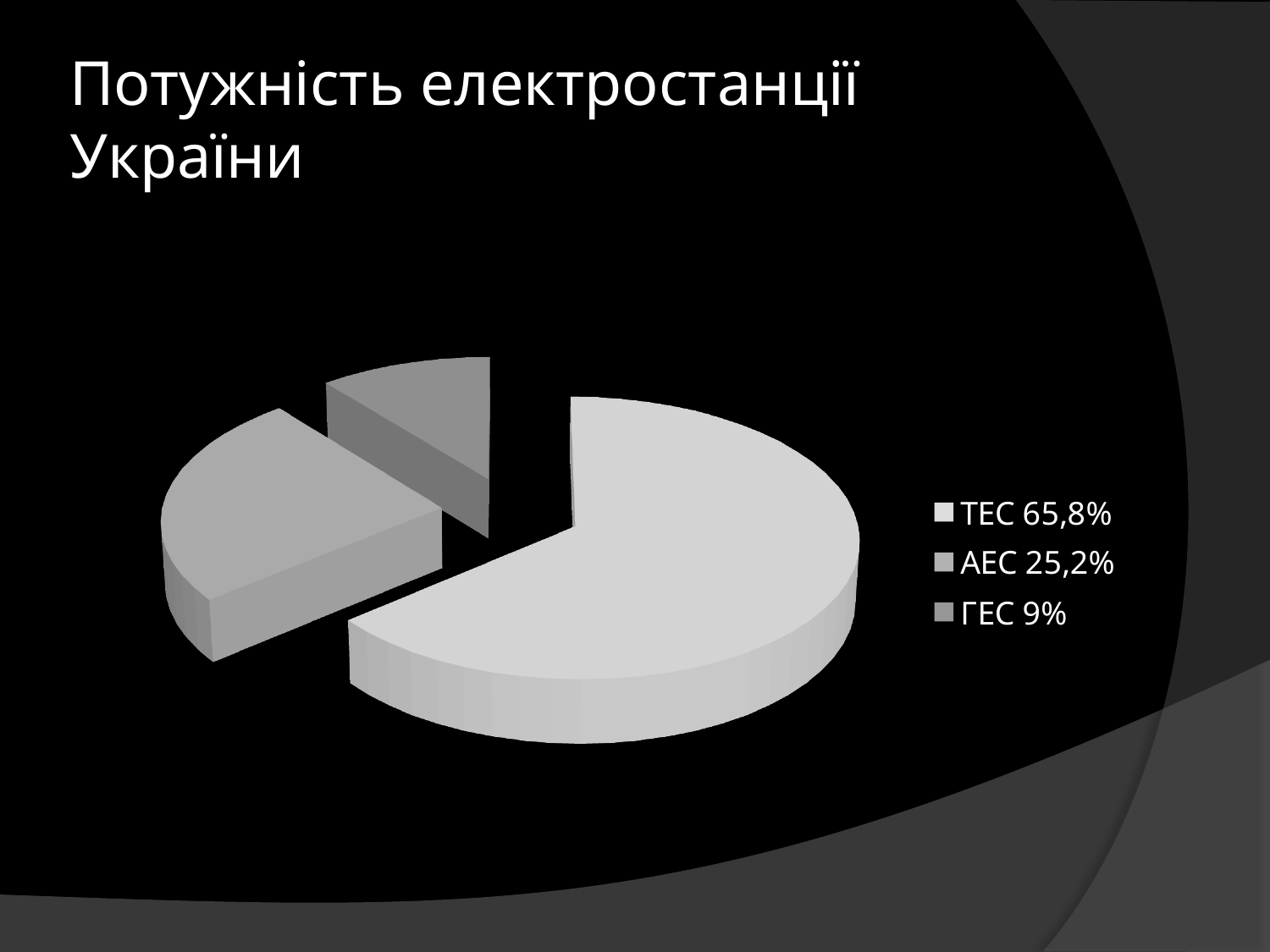
What is the title of the slide? Потужність електростанції України What share of the pie does ТЕС account for? 65,8% What is the difference in percentage points between the АЕС and ГЕС shares? 16,2% How many slices does the pie chart have? 3 Which category has the largest slice of the pie? ТЕС Which legend entry is listed first? ТЕС 65,8% What kind of chart is shown on the slide? Pie chart What share of the pie does ГЕС account for? 9% What share of the pie does АЕС account for? 25,2% Which category has the smallest slice of the pie? ГЕС Which is larger, the share for АЕС or the share for ГЕС? АЕС What is the difference in percentage points between the ТЕС and АЕС shares? 40,6%